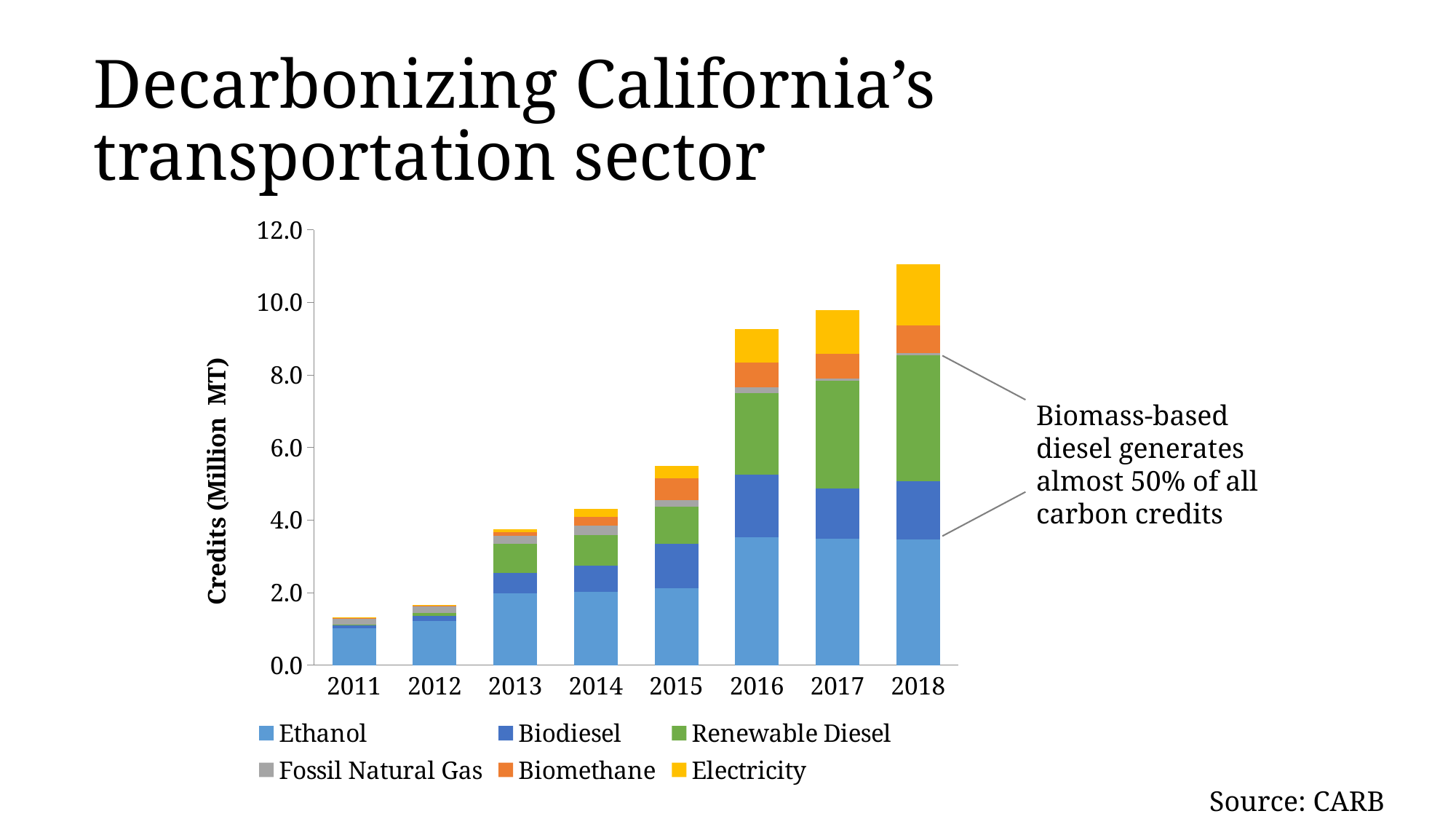
Do the total credits rise or fall from 2011 to 2018? Rise How many years are shown along the x axis of the chart? 8 Which year has a larger total bar, 2015 or 2016? 2016 Is the total value of the 2015 bar greater or less than 6.0? less What is the label on the chart's vertical axis? Credits (Million MT) Is the total value of the 2011 bar greater or less than 2.0? less Is the total value of the 2018 bar greater or less than 10.0? greater How many series does the chart's legend list? 6 Which year has the shortest stacked bar (lowest total credits)? 2011 Which year has the tallest stacked bar (highest total credits)? 2018 What kind of chart is shown on the slide? Stacked bar chart